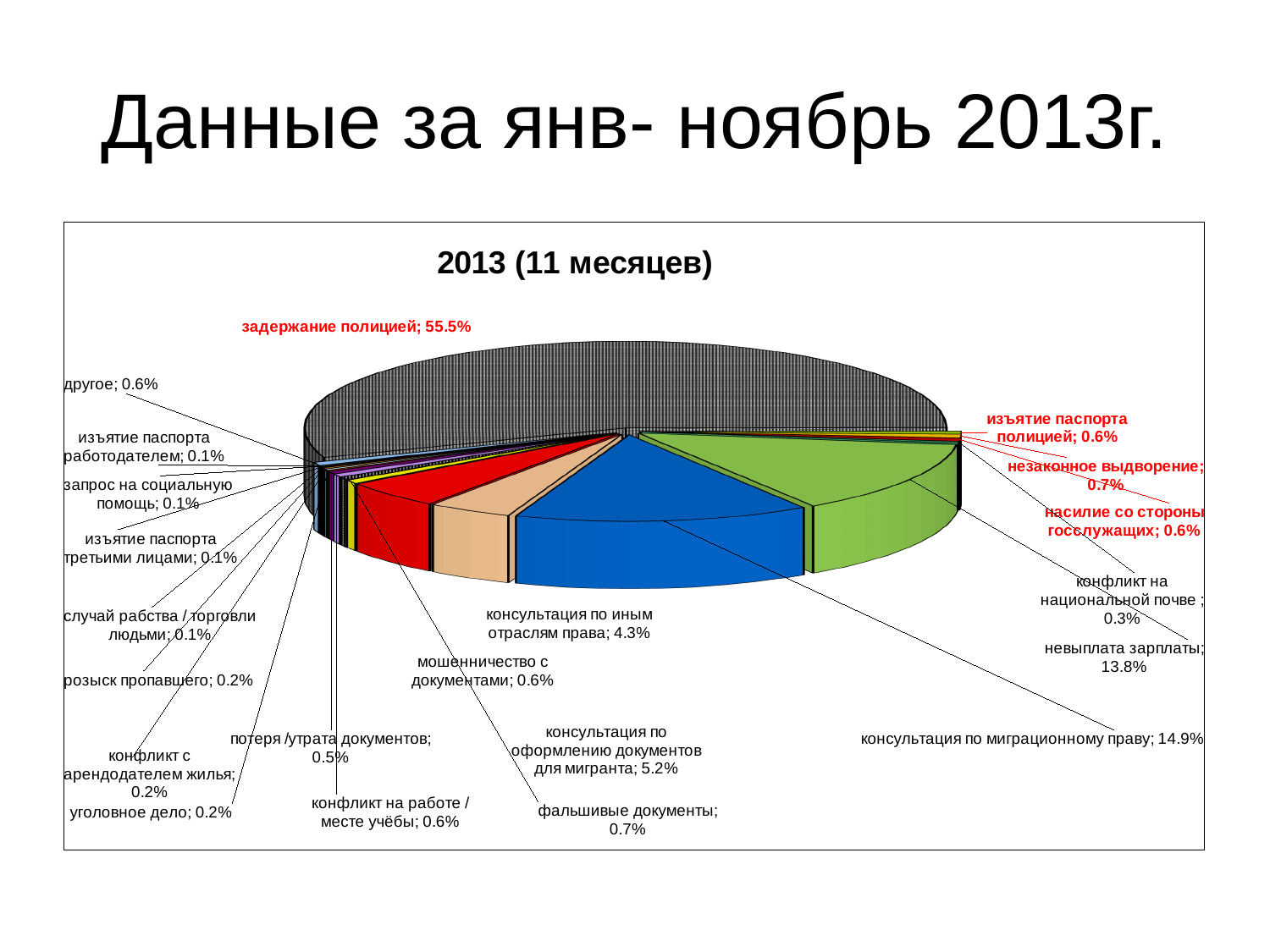
What share does "фальшивые документы" have? 0.7% What kind of chart is shown on the slide? pie chart What is the title of the chart? 2013 (11 месяцев) What is the smallest share value shown on the chart? 0.1% Which category has the largest share of the pie? задержание полицией What is the difference between the shares of "консультация по миграционному праву" and "невыплата зарплаты"? 1.1% What share does "невыплата зарплаты" have? 13.8% Which is larger: "консультация по иным отраслям права" or "консультация по оформлению документов для мигранта"? консультация по оформлению документов для мигранта What share does "консультация по миграционному праву" have? 14.9% What share does "консультация по оформлению документов для мигранта" have? 5.2% What share does "задержание полицией" have? 55.5% How many categories (slices) are labelled on the chart? 21